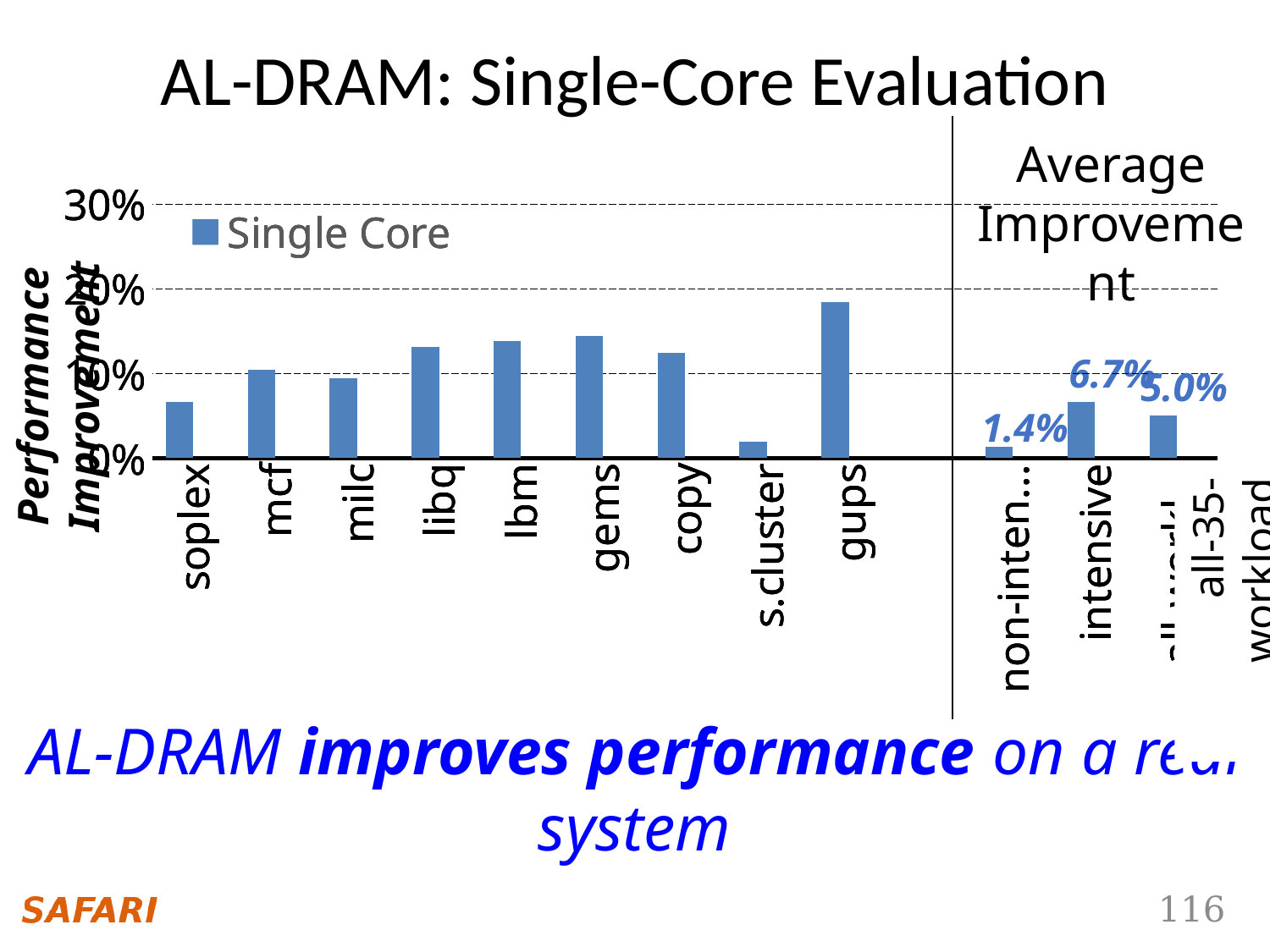
What is the name of the series shown in the legend? Single Core Which has a larger performance improvement, gups or lbm? gups Is the performance improvement for gups greater or less than 20%? less What is the average performance improvement shown for the all-35-workload category? 5.0% How many series does the legend list? 1 Which of the nine individual benchmarks (left of the divider) has the highest performance improvement? gups What is the difference between the average improvement for intensive workloads and for all-35-workload? 1.7% What is the average performance improvement shown for the intensive workloads? 6.7% What type of chart is shown on the slide? bar chart What is the average performance improvement shown for the non-intensive workloads? 1.4% Which of the nine individual benchmarks (left of the divider) has the lowest performance improvement? s.cluster How many individual benchmarks are plotted to the left of the vertical divider line? 9